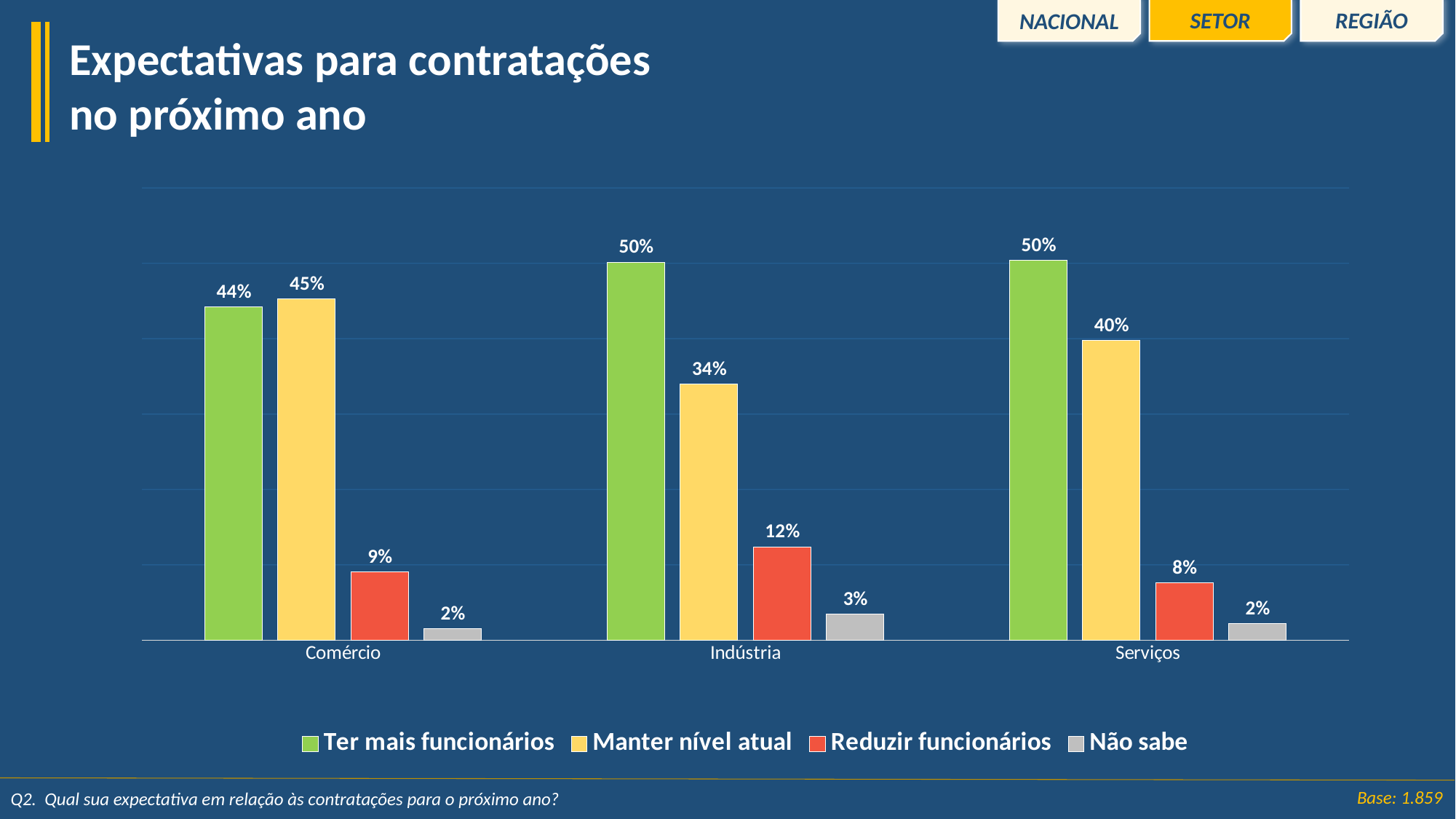
What is the value for "Não sabe" in the Indústria category? 3% What kind of chart is shown on the slide? Bar chart What is the difference between "Ter mais funcionários" and "Manter nível atual" in the Serviços category? 10% Which colour represents "Reduzir funcionários" in the legend? Red What is the value for "Ter mais funcionários" in the Comércio category? 44% Which is larger in the Comércio category: "Ter mais funcionários" or "Manter nível atual"? Manter nível atual What is the value for "Reduzir funcionários" in the Serviços category? 8% How many series does the legend list? 4 How many categories are shown on the x axis? 3 Which category has the lowest value for "Reduzir funcionários"? Serviços What is the value for "Manter nível atual" in the Indústria category? 34% Which category has the highest value for "Manter nível atual"? Comércio